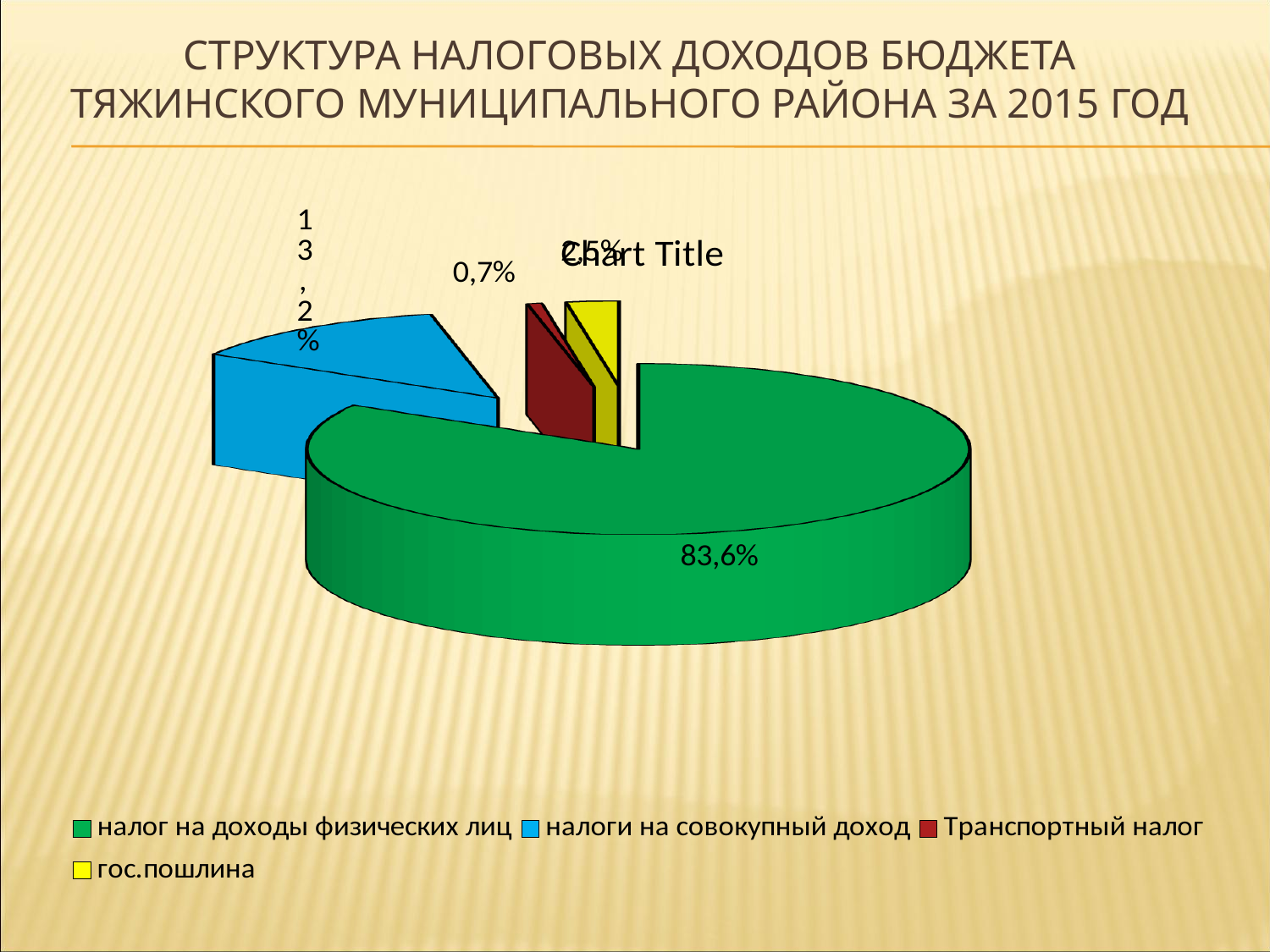
Which category has the largest slice of the pie? налог на доходы физических лиц How many entries does the legend list? 4 By how many percentage points does налог на доходы физических лиц exceed налоги на совокупный доход? 70,4 What kind of chart is shown on the slide? pie chart What is the title printed on the chart itself? Chart Title What colour is the slice for налог на доходы физических лиц? green What share of tax revenues does налог на доходы физических лиц account for? 83,6% How many categories are shown in the pie chart? 4 What share of tax revenues does налоги на совокупный доход account for? 13,2% Which is larger: налог на доходы физических лиц or налоги на совокупный доход? налог на доходы физических лиц